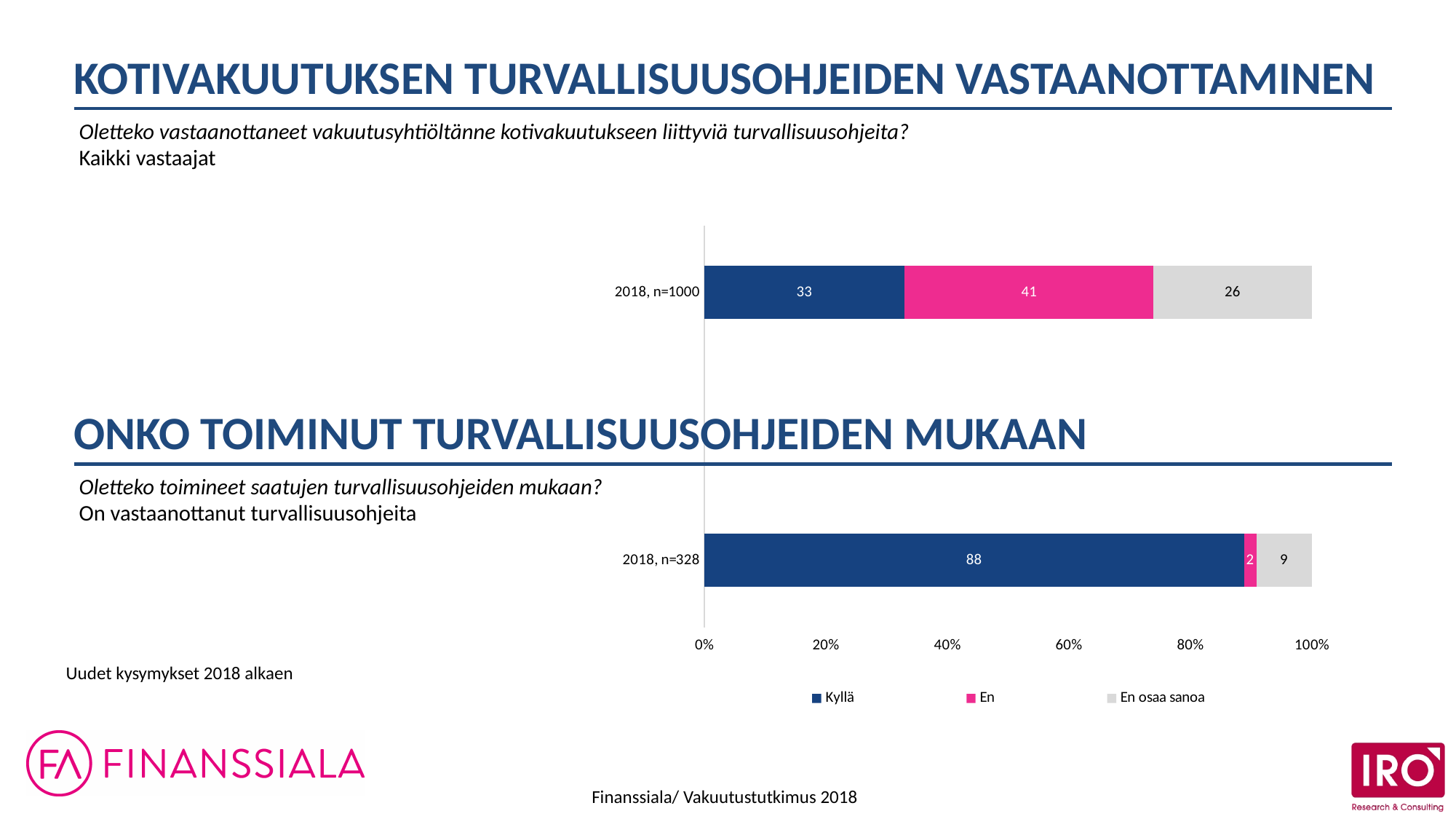
Which response has the smallest value in the bar labelled 2018, n=328? En What is the value for En osaa sanoa in the bar labelled 2018, n=328? 9 What is the value for En in the bar labelled 2018, n=1000? 41 What is the difference between the Kyllä value in the 2018, n=328 bar and the Kyllä value in the 2018, n=1000 bar? 55 What kind of chart is shown on the slide? Stacked bar chart What is the total of the segments in the bar labelled 2018, n=1000? 100 In the bar labelled 2018, n=1000, which is larger: Kyllä or En? En What is the value for En in the bar labelled 2018, n=328? 2 How many bars are plotted in the chart? 2 Which response has the largest value in the bar labelled 2018, n=1000? En What is the value for Kyllä in the bar labelled 2018, n=1000? 33 How many series does the legend list? 3